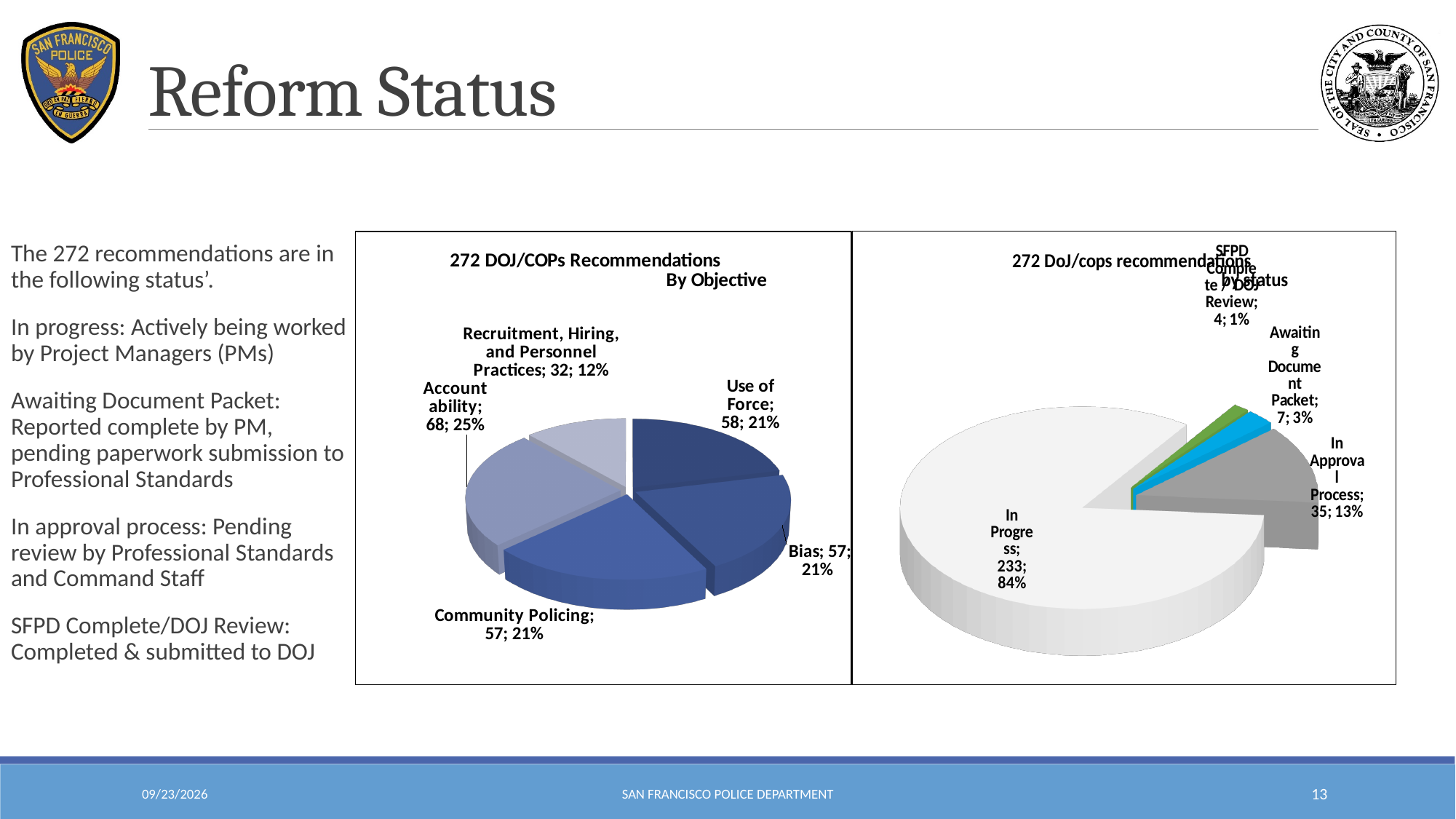
In the right chart, '272 DoJ/cops recommendations by status', which status has the fewest recommendations? SFPD Complete / DOJ Review In the left chart, '272 DOJ/COPs Recommendations By Objective', which objective has the most recommendations? Accountability In the right chart, '272 DoJ/cops recommendations by status', how many status categories are shown? 4 In the right chart, '272 DoJ/cops recommendations by status', which is larger: Awaiting Document Packet or In Approval Process? In Approval Process In the right chart, '272 DoJ/cops recommendations by status', what share of recommendations is In Approval Process? 13% What type of chart is the left chart, '272 DOJ/COPs Recommendations By Objective'? Pie chart In the left chart, '272 DOJ/COPs Recommendations By Objective', what is the difference between the Accountability count and the Use of Force count? 10 In the left chart, '272 DOJ/COPs Recommendations By Objective', how many recommendations fall under Accountability? 68 In the right chart, '272 DoJ/cops recommendations by status', how many recommendations are In Progress? 233 In the left chart, '272 DOJ/COPs Recommendations By Objective', how many objective categories are shown? 5 In the left chart, '272 DOJ/COPs Recommendations By Objective', which objective has the fewest recommendations? Recruitment, Hiring, and Personnel Practices In the left chart, '272 DOJ/COPs Recommendations By Objective', what share of recommendations is Recruitment, Hiring, and Personnel Practices? 12%